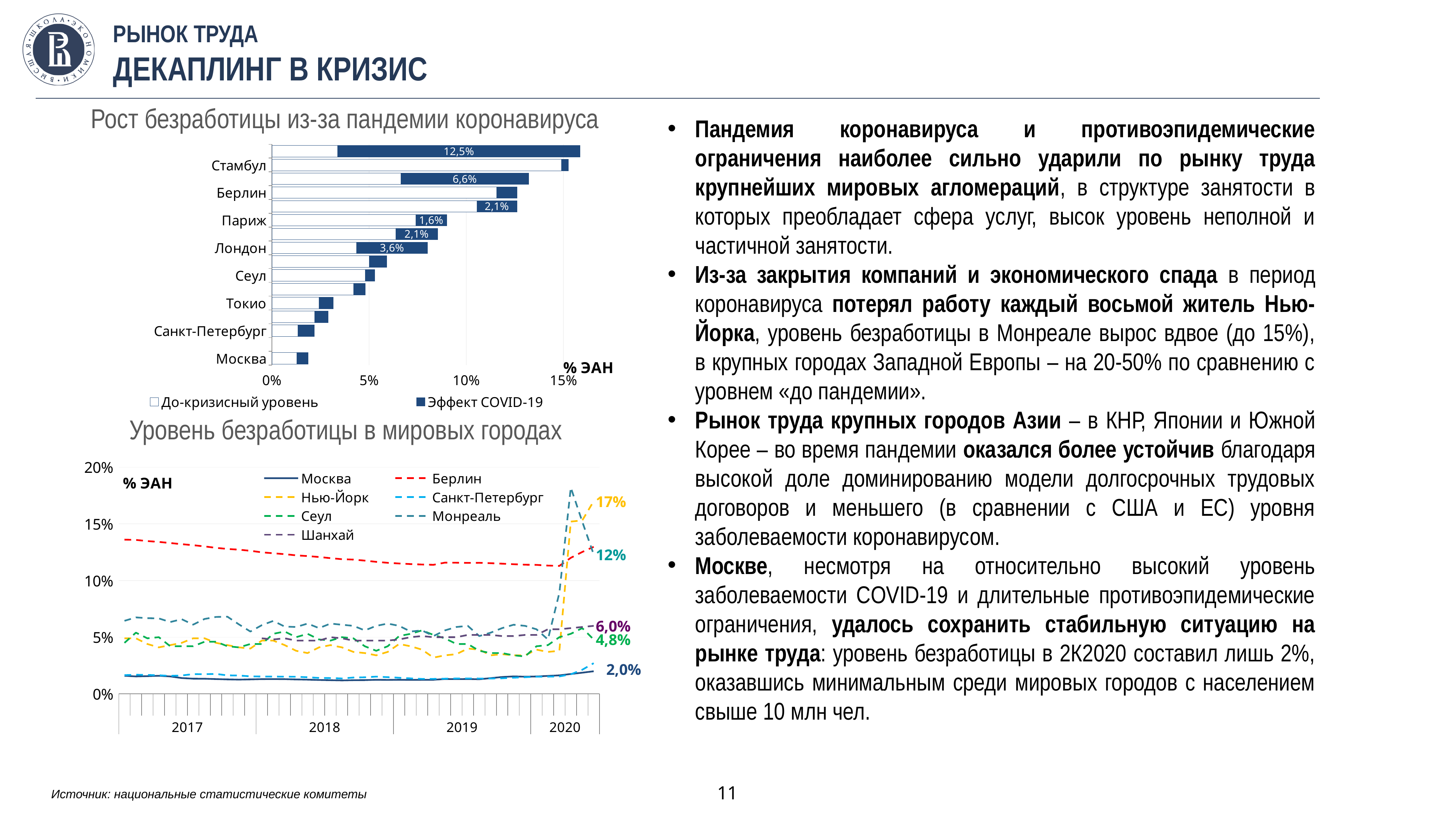
In the chart 'Рост безработицы из-за пандемии коронавируса', is the total bar length for Москва greater or less than 5%? less In the chart 'Рост безработицы из-за пандемии коронавируса', how many series does the legend list? 2 In the chart 'Уровень безработицы в мировых городах', what kind of chart is it? line chart In the chart 'Рост безработицы из-за пандемии коронавируса', what is the labelled 'Эффект COVID-19' value for Париж? 1,6% In the chart 'Рост безработицы из-за пандемии коронавируса', what is the labelled 'Эффект COVID-19' value for Лондон? 3,6% In the chart 'Уровень безработицы в мировых городах', what is the labelled final value for Москва? 2,0% In the chart 'Рост безработицы из-за пандемии коронавируса', which has the larger 'Эффект COVID-19' value, Лондон or Париж? Лондон In the chart 'Уровень безработицы в мировых городах', does the Берлин line rise or fall from 2017 to 2019? fall In the chart 'Уровень безработицы в мировых городах', what is the labelled final value for Нью-Йорк? 17% In the chart 'Уровень безработицы в мировых городах', how many series does the legend list? 7 In the chart 'Рост безработицы из-за пандемии коронавируса', is the total bar length for Стамбул greater or less than 10%? greater In the chart 'Рост безработицы из-за пандемии коронавируса', what kind of chart is it? bar chart